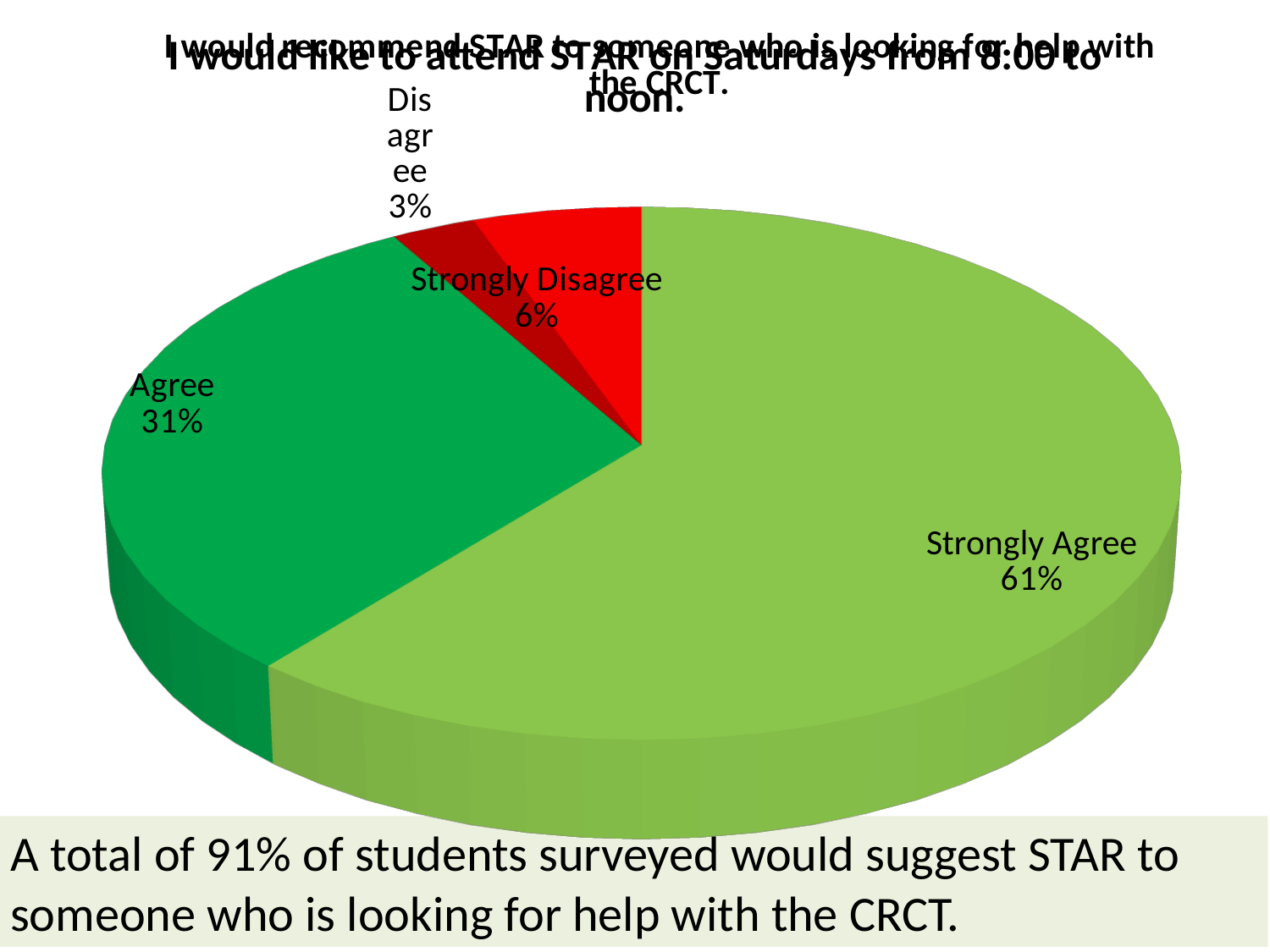
What percentage of the pie chart is Strongly Disagree? 6% What percentage of the pie chart is Disagree? 3% How many slices does the pie chart have? 4 Which category has the largest slice of the pie chart? Strongly Agree What percentage of the pie chart is Strongly Agree? 61% How many percentage points larger is Strongly Disagree than Disagree? 3 Which category has the smallest slice of the pie chart? Disagree Which is larger, the Agree slice or the Strongly Disagree slice? Agree What kind of chart is shown on the slide? Pie chart How many percentage points larger is Strongly Agree than Agree? 30 What percentage of the pie chart is Agree? 31% What colour is the Strongly Disagree slice of the pie chart? Red